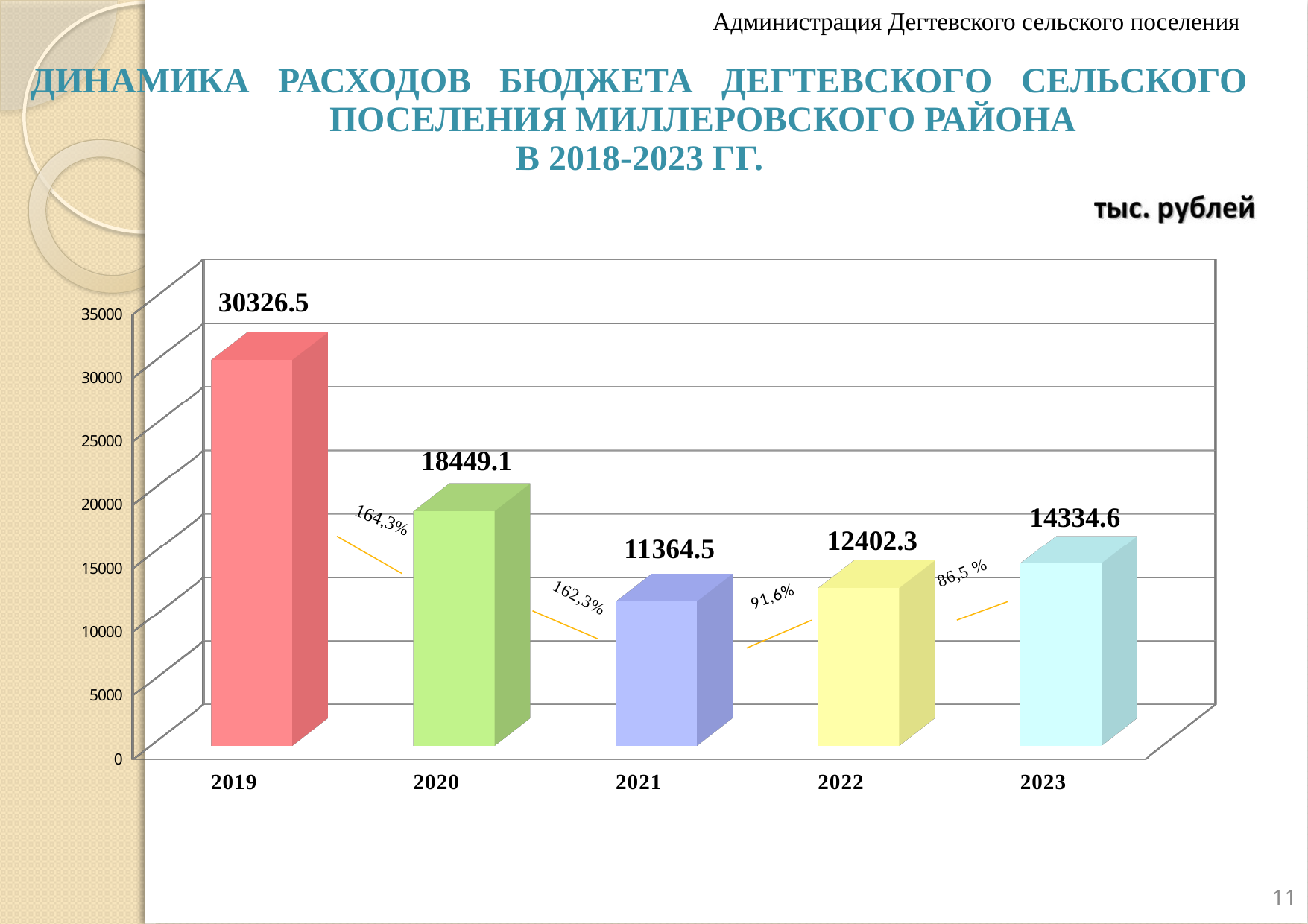
Do the values rise or fall from 2021 to 2023? rise Is the value for 2020 greater or less than 20000? less What is the value for 2021? 11364.5 Which year has the lowest value? 2021 What is the value for 2023? 14334.6 What is the difference between the values for 2023 and 2022? 1932.3 What is the difference between the values for 2019 and 2020? 11877.4 Which is larger, the value for 2022 or the value for 2023? 2023 What kind of chart is shown on the slide? bar chart What is the value for 2019? 30326.5 Which year has the highest value? 2019 How many years are shown on the x axis? 5